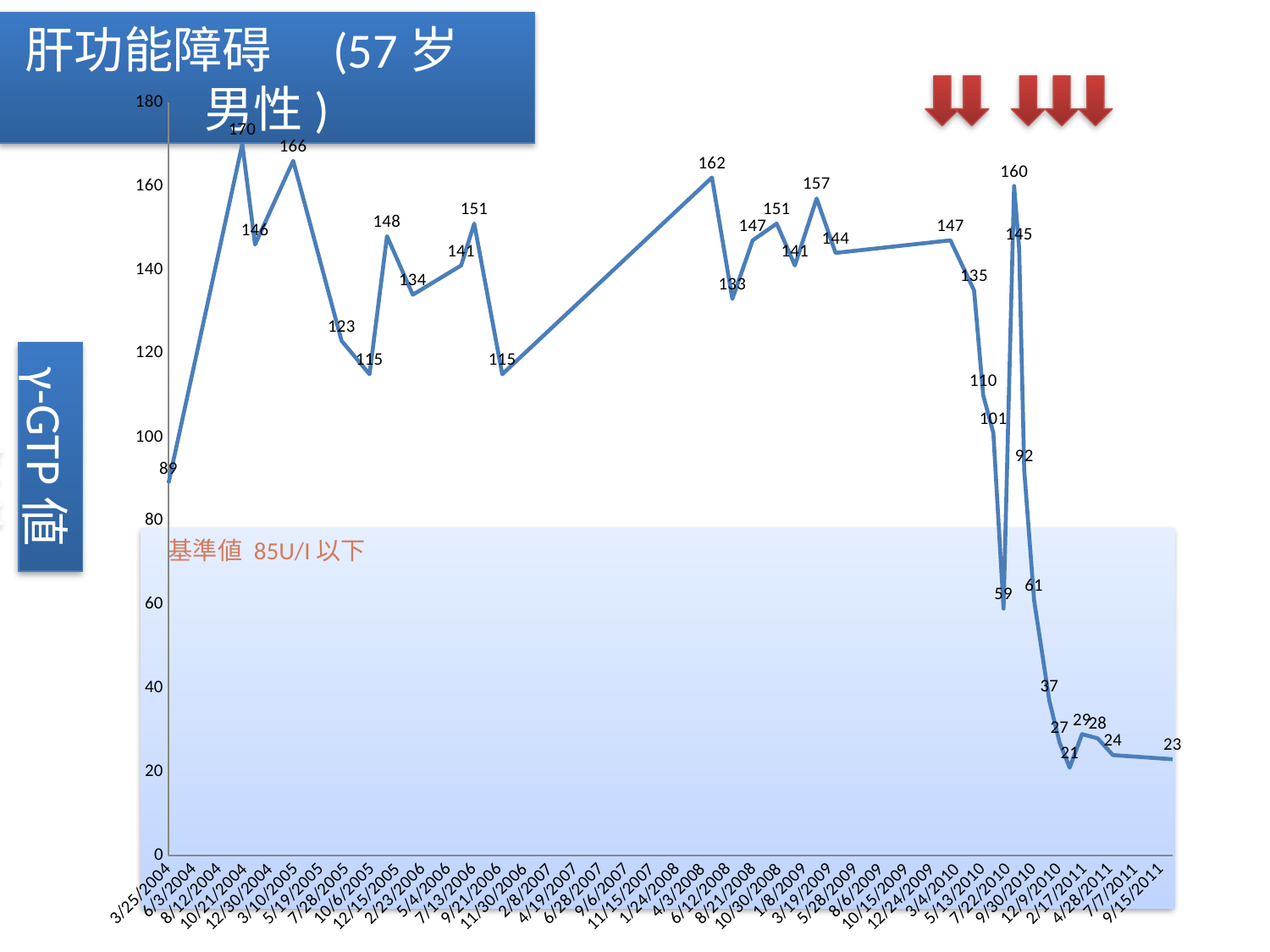
What is the lowest γ-GTP value plotted on the chart? 21 What kind of chart is shown on the slide? line chart What is the highest γ-GTP value plotted on the chart? 170 Which is larger, the peak labelled 166 or the peak labelled 162? 166 What is the difference between the first data point (89) and the last data point (23)? 66 What reference value is stated in the shaded region of the chart? 基準値 85U/l 以下 What is the difference between the highest value (170) and the lowest value (21) on the chart? 149 What is the label on the vertical axis of the chart? γ-GTP 値 Overall, do the γ-GTP values rise or fall from the start of the chart to the end? fall What is the value of the first data point on the chart (3/25/2004)? 89 What is the value of the last data point on the chart? 23 Which is larger, the first data point or the last data point on the chart? the first data point (89)